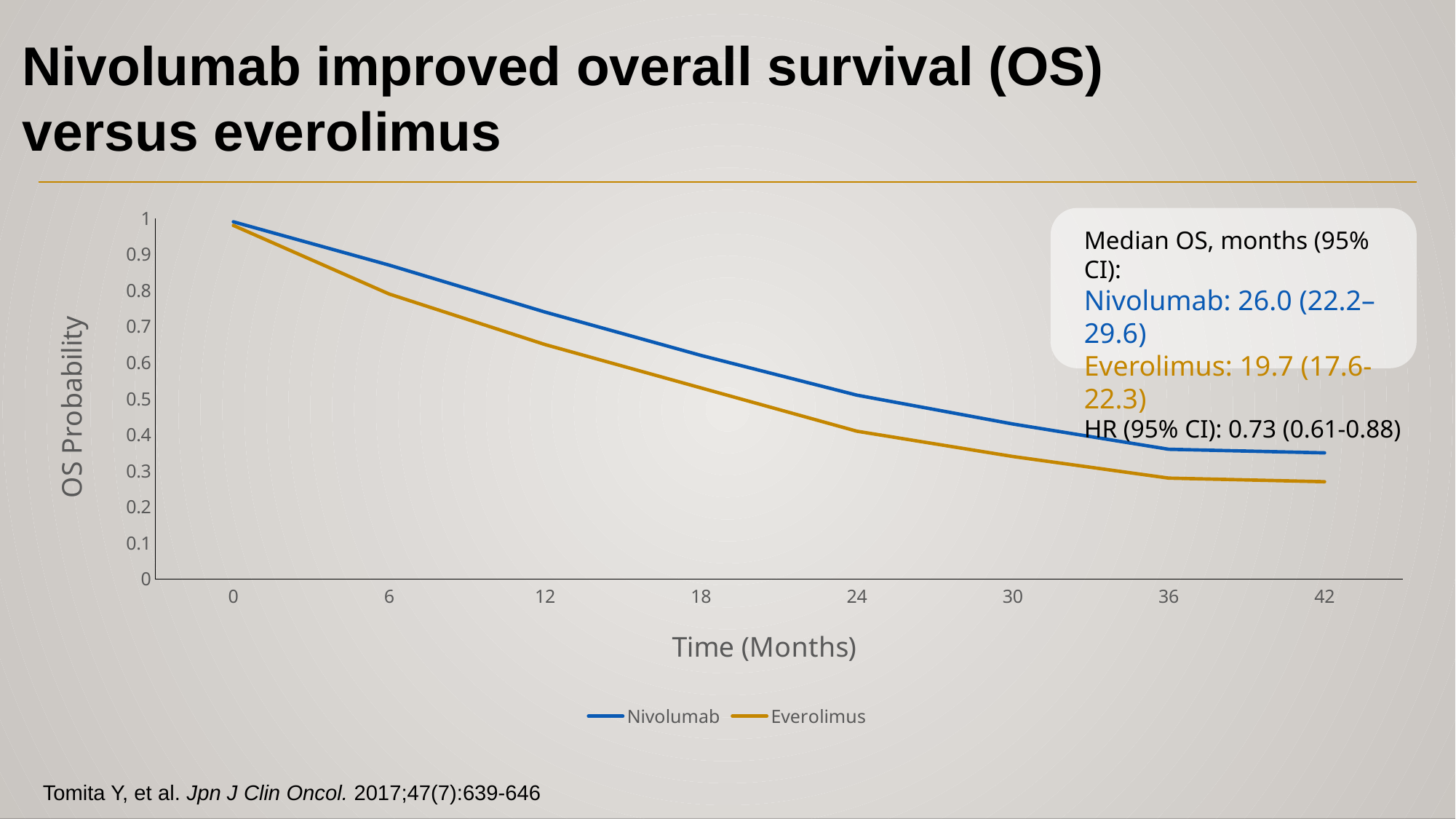
Is the OS probability for Everolimus at 24 months greater or less than 0.5? less What kind of chart is shown on the slide? line chart Which series is plotted in blue? Nivolumab Do the OS probability values rise or fall as time increases along the x axis? fall How many time points are labelled on the x axis? 8 Is the OS probability for Everolimus at 6 months greater or less than 0.7? greater What is the median OS in months for Nivolumab according to the text box on the chart? 26.0 At 24 months, which series has the higher OS probability, Nivolumab or Everolimus? Nivolumab How many series does the legend list? 2 Is the OS probability for Nivolumab at 42 months greater or less than 0.4? less What is the hazard ratio (HR) shown on the chart? 0.73